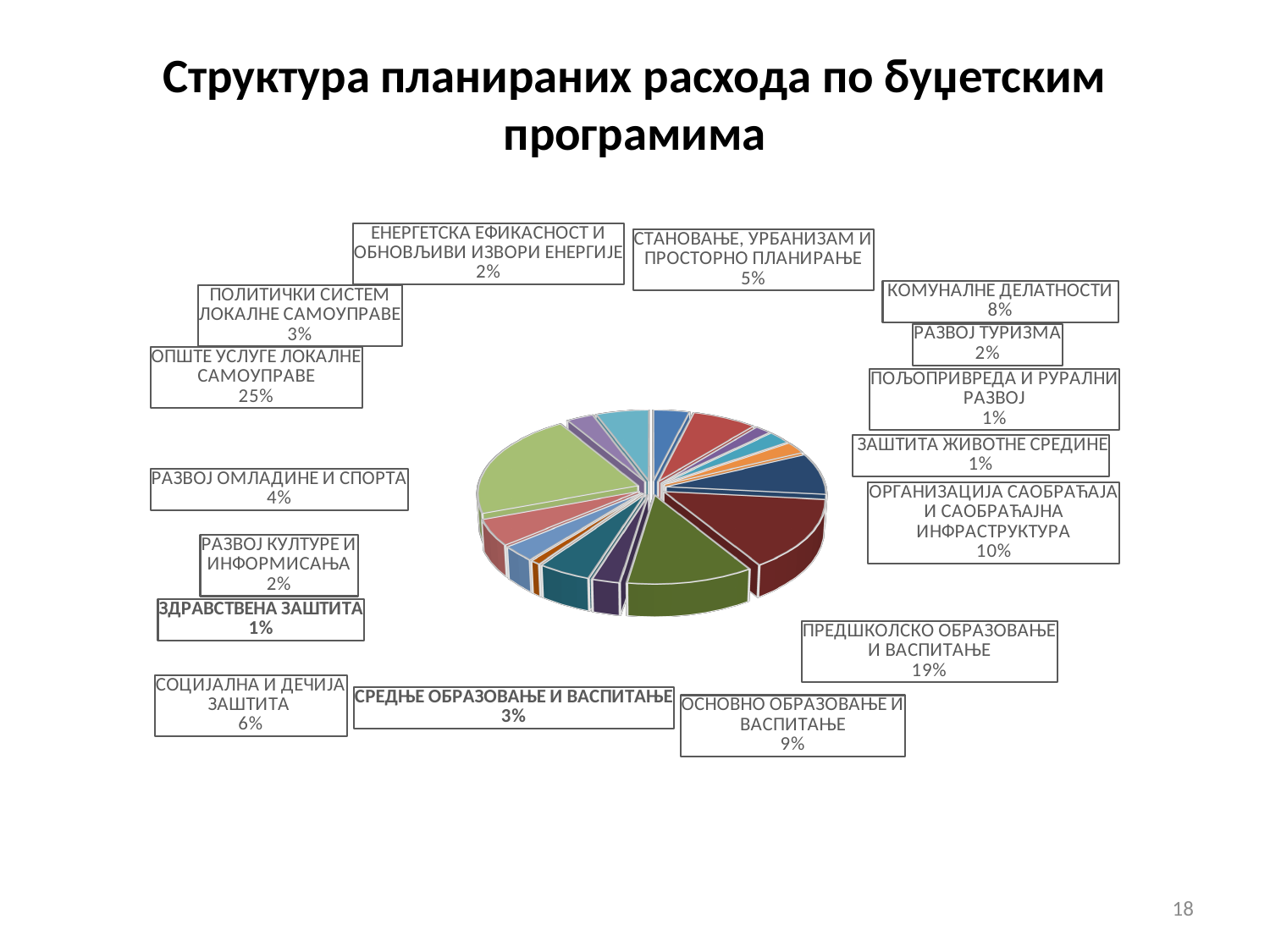
What percentage is shown for ПРЕДШКОЛСКО ОБРАЗОВАЊЕ И ВАСПИТАЊЕ? 19% What is the difference in percentage points between ОПШТЕ УСЛУГЕ ЛОКАЛНЕ САМОУПРАВЕ and ПРЕДШКОЛСКО ОБРАЗОВАЊЕ И ВАСПИТАЊЕ? 6 percentage points How many budget programs (slices) are labelled on the pie chart? 16 Which budget program has the largest share of planned expenditure? ОПШТЕ УСЛУГЕ ЛОКАЛНЕ САМОУПРАВЕ What share of planned expenditure goes to ОПШТЕ УСЛУГЕ ЛОКАЛНЕ САМОУПРАВЕ? 25% What is the title of the chart on the slide? Структура планираних расхода по буџетским програмима What type of chart is shown on the slide? pie chart What percentage is shown for СОЦИЈАЛНА И ДЕЧИЈА ЗАШТИТА? 6% Which has a larger share: ОСНОВНО ОБРАЗОВАЊЕ И ВАСПИТАЊЕ or СРЕДЊЕ ОБРАЗОВАЊЕ И ВАСПИТАЊЕ? ОСНОВНО ОБРАЗОВАЊЕ И ВАСПИТАЊЕ What percentage is shown for КОМУНАЛНЕ ДЕЛАТНОСТИ? 8% What percentage is shown for РАЗВОЈ ОМЛАДИНЕ И СПОРТА? 4% What percentage is shown for ОРГАНИЗАЦИЈА САОБРАЋАЈА И САОБРАЋАЈНА ИНФРАСТРУКТУРА? 10%